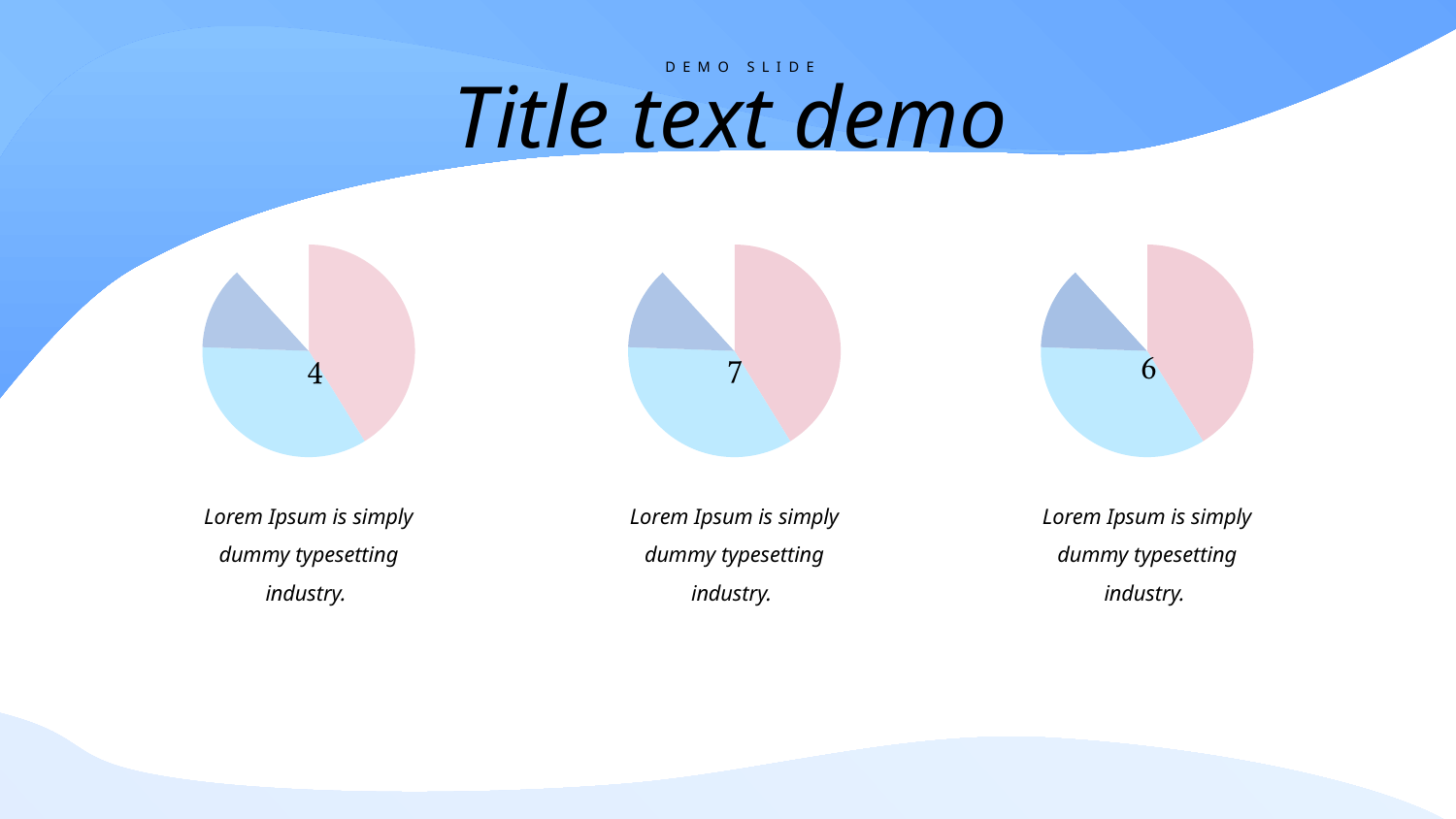
What number is printed on the left pie chart? 4 What number is printed on the middle pie chart? 7 What kind of chart is shown on the left of the slide? Pie chart What is the title text at the top of the slide? Title text demo In the right pie chart, which is larger, the light blue slice or the darker blue-grey slice? The light blue slice In the middle pie chart, which is larger, the pink slice or the darker blue-grey slice? The pink slice What number is printed on the right pie chart? 6 How many pie charts are on the slide? 3